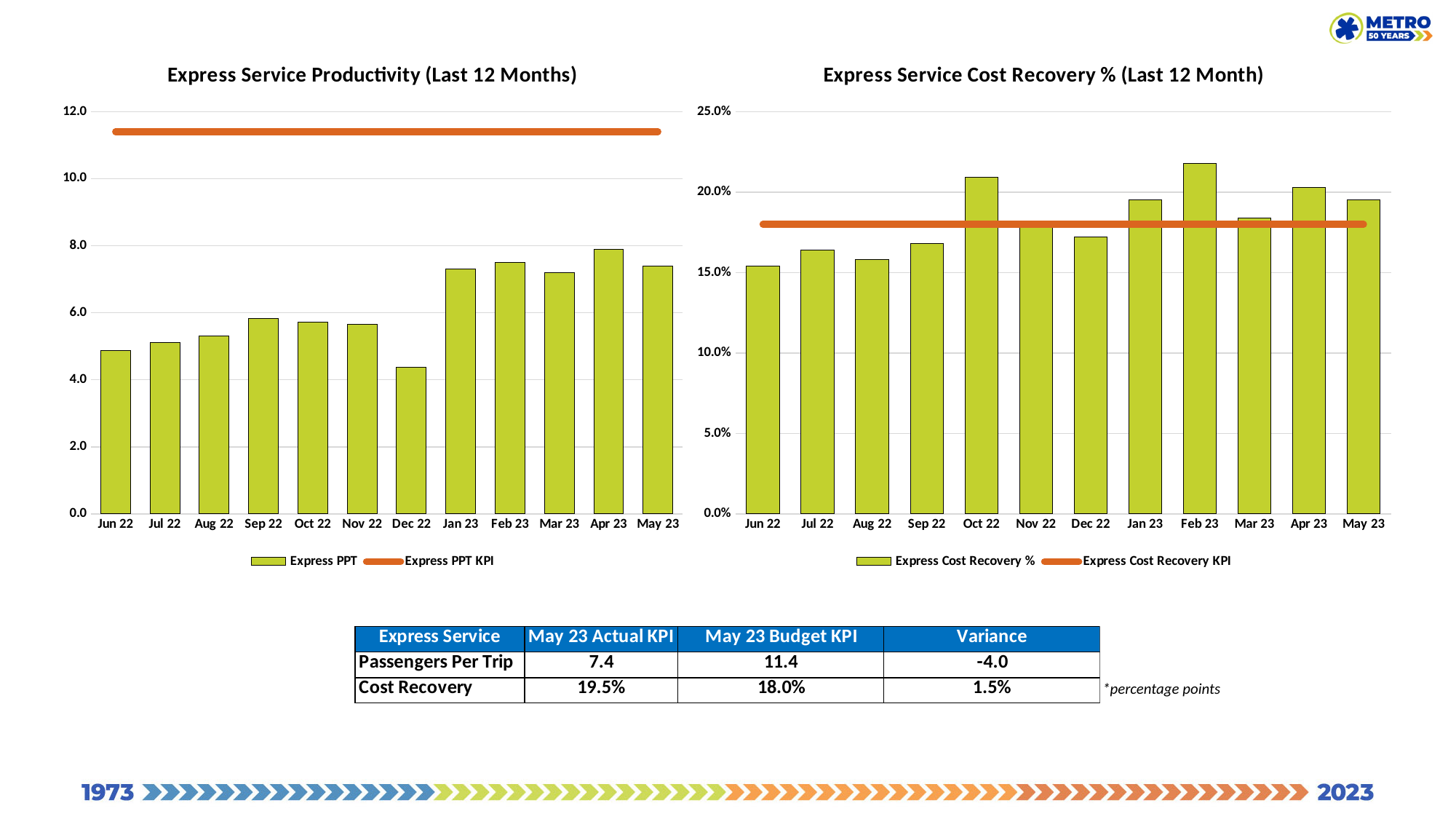
What kind of chart is the Express Service Productivity (Last 12 Months) chart? combination bar and line chart How many series does the legend of the Express Service Productivity (Last 12 Months) chart list? 2 In the Express Service Productivity (Last 12 Months) chart, do the Express PPT values generally rise or fall from Jun 22 to May 23? rise In the Express Service Productivity (Last 12 Months) chart, which month has the lowest Express PPT bar? Dec 22 In the Express Service Productivity (Last 12 Months) chart, is the Express PPT value for Dec 22 greater or less than 6.0? less In the Express Service Cost Recovery % (Last 12 Month) chart, is the Express Cost Recovery % value for Oct 22 greater or less than 20.0%? greater In the Express Service Productivity (Last 12 Months) chart, which is higher, the Express PPT bar for Jan 23 or for Jun 22? Jan 23 In the Express Service Cost Recovery % (Last 12 Month) chart, is the Express Cost Recovery % value for Jun 22 greater or less than 20.0%? less How many months are shown on the x axis of the Express Service Cost Recovery % (Last 12 Month) chart? 12 In the Express Service Productivity (Last 12 Months) chart, which month has the highest Express PPT bar? Apr 23 In the Express Service Cost Recovery % (Last 12 Month) chart, which month has the highest Express Cost Recovery % bar? Feb 23 In the Express Service Cost Recovery % (Last 12 Month) chart, what colour is the Express Cost Recovery KPI line? orange